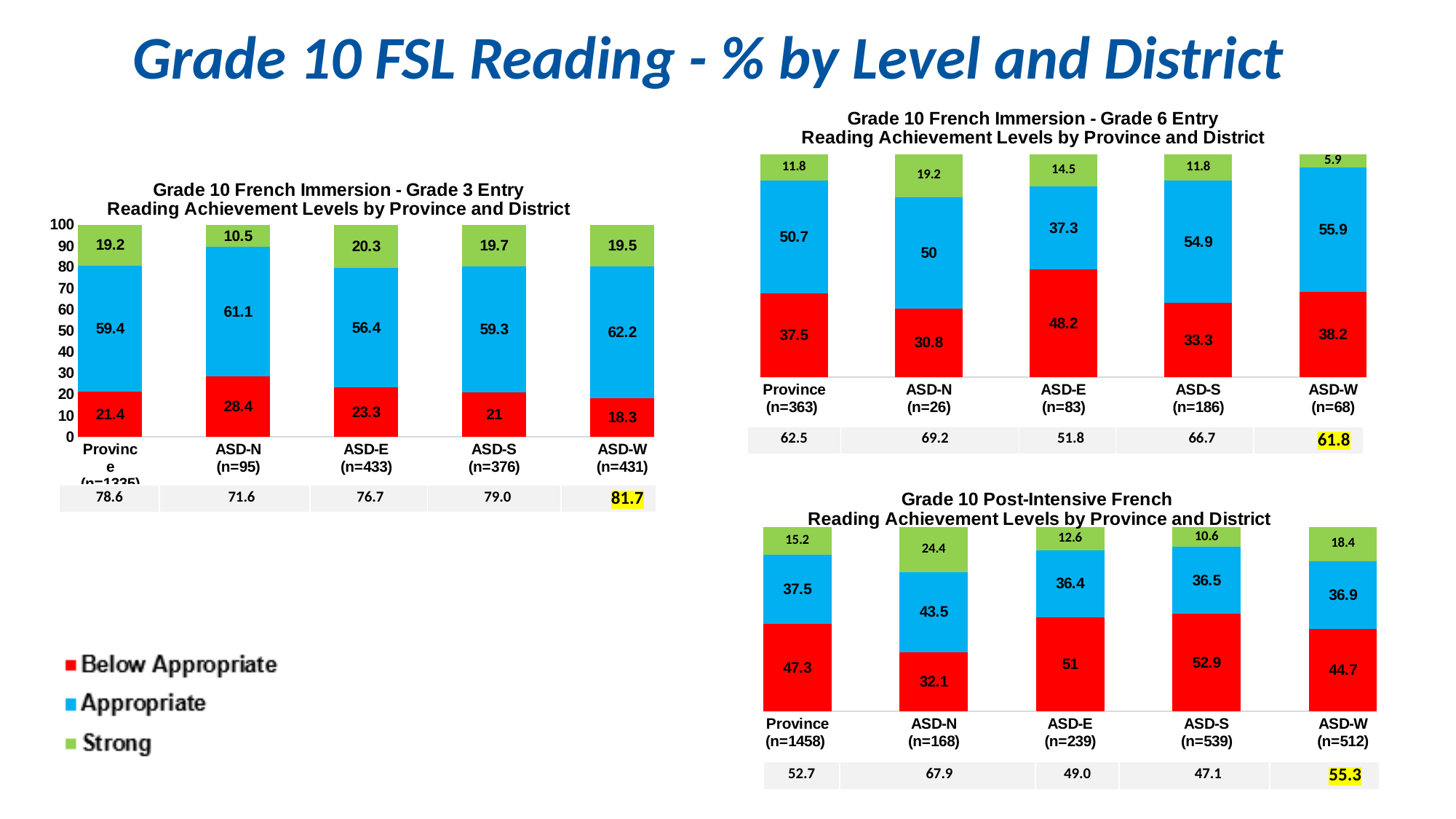
In the Grade 10 Post-Intensive French chart, is the Below Appropriate value larger for Province or ASD-W? Province In the Grade 10 French Immersion - Grade 3 Entry chart, which district has the lowest Strong value? ASD-N In the Grade 10 Post-Intensive French chart, what is the Strong value for ASD-N? 24.4 What type of chart is the Grade 10 French Immersion - Grade 3 Entry chart? Stacked bar chart How many series does the legend on the slide list? 3 In the Grade 10 French Immersion - Grade 6 Entry chart, which category has the highest Appropriate value? ASD-W In the Grade 10 French Immersion - Grade 3 Entry chart, what is the Below Appropriate value for ASD-N? 28.4 In the Grade 10 French Immersion - Grade 6 Entry chart, what is the Below Appropriate value for ASD-E? 48.2 In the Grade 10 French Immersion - Grade 3 Entry chart, what is the Appropriate value for ASD-W? 62.2 How many categories are shown on the x axis of the Grade 10 Post-Intensive French chart? 5 In the Grade 10 Post-Intensive French chart, which category has the highest Below Appropriate value? ASD-S In the Grade 10 French Immersion - Grade 6 Entry chart, what is the difference between the Below Appropriate values for ASD-E and ASD-N? 17.4